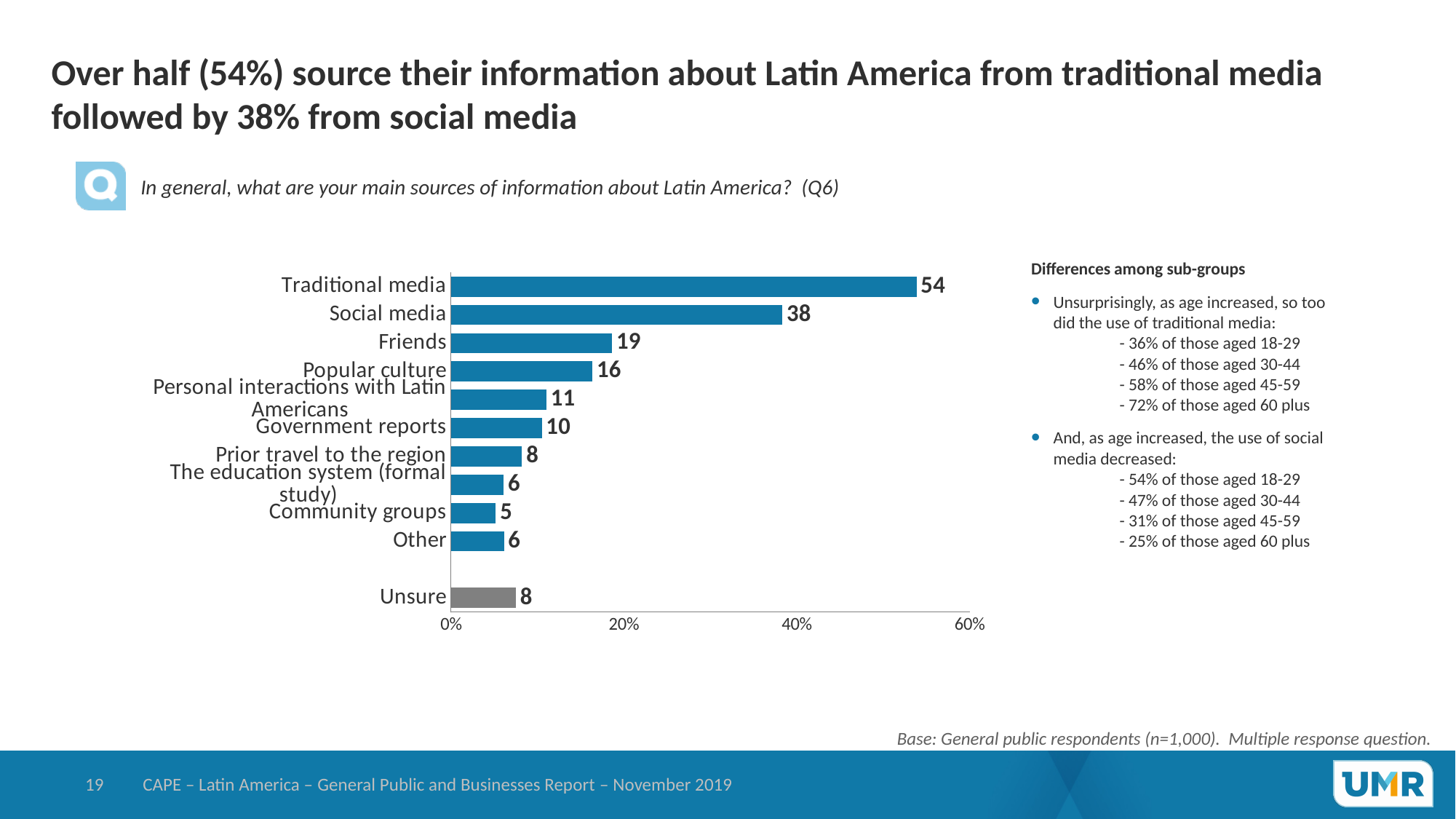
How many categories are shown in the chart? 11 What is the value for Government reports? 10 What is the value for Traditional media? 54 Which category has the lowest value? Community groups Which category has the highest value? Traditional media Which is larger, the value for Personal interactions with Latin Americans or the value for Government reports? Personal interactions with Latin Americans What kind of chart is shown on the slide? Bar chart What is the value for Social media? 38 What is the difference between the values for Traditional media and Social media? 16 What is the value for Unsure? 8 What is the difference between the values for Friends and Popular culture? 3 Is the value for Social media greater or less than 40%? less